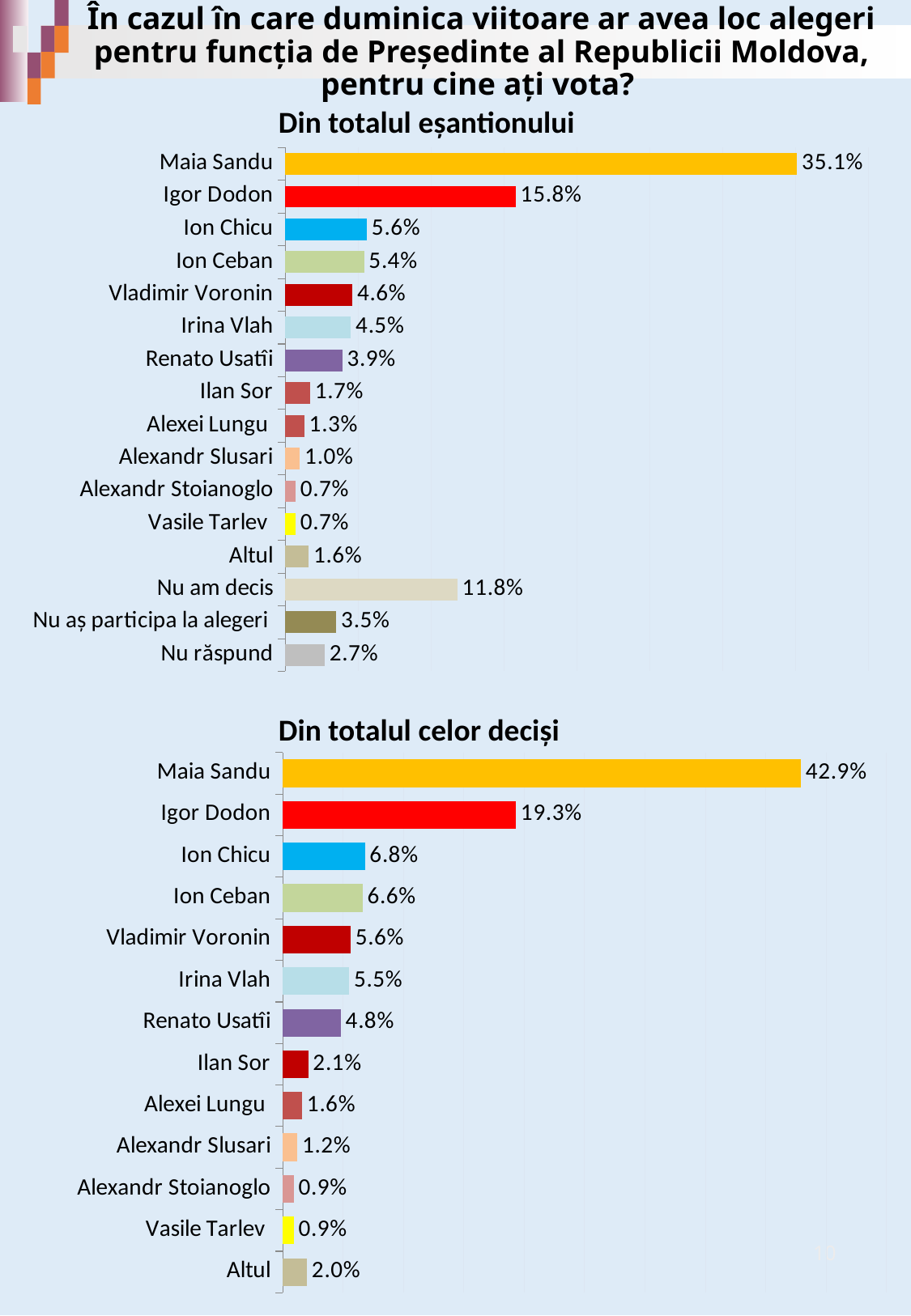
How many categories are shown in the 'Din totalul celor deciși' chart? 13 In the 'Din totalul eșantionului' chart, which category has the lowest value? Alexandr Stoianoglo and Vasile Tarlev (0.7%) In the 'Din totalul eșantionului' chart, what is the value for Maia Sandu? 35.1% In the 'Din totalul celor deciși' chart, what is the value for Igor Dodon? 19.3% In the 'Din totalul eșantionului' chart, what is the difference between Ion Chicu and Ion Ceban? 0.2% How many categories are shown in the 'Din totalul eșantionului' chart? 16 In the 'Din totalul eșantionului' chart, which is larger: Nu am decis or Igor Dodon? Igor Dodon In the 'Din totalul celor deciși' chart, which category has the highest value? Maia Sandu In the 'Din totalul celor deciși' chart, what is the value for Renato Usatîi? 4.8% What type of chart is the 'Din totalul celor deciși' chart? Bar chart In the 'Din totalul eșantionului' chart, what is the value for Nu am decis? 11.8% In the 'Din totalul celor deciși' chart, what is the difference between Maia Sandu and Igor Dodon? 23.6%